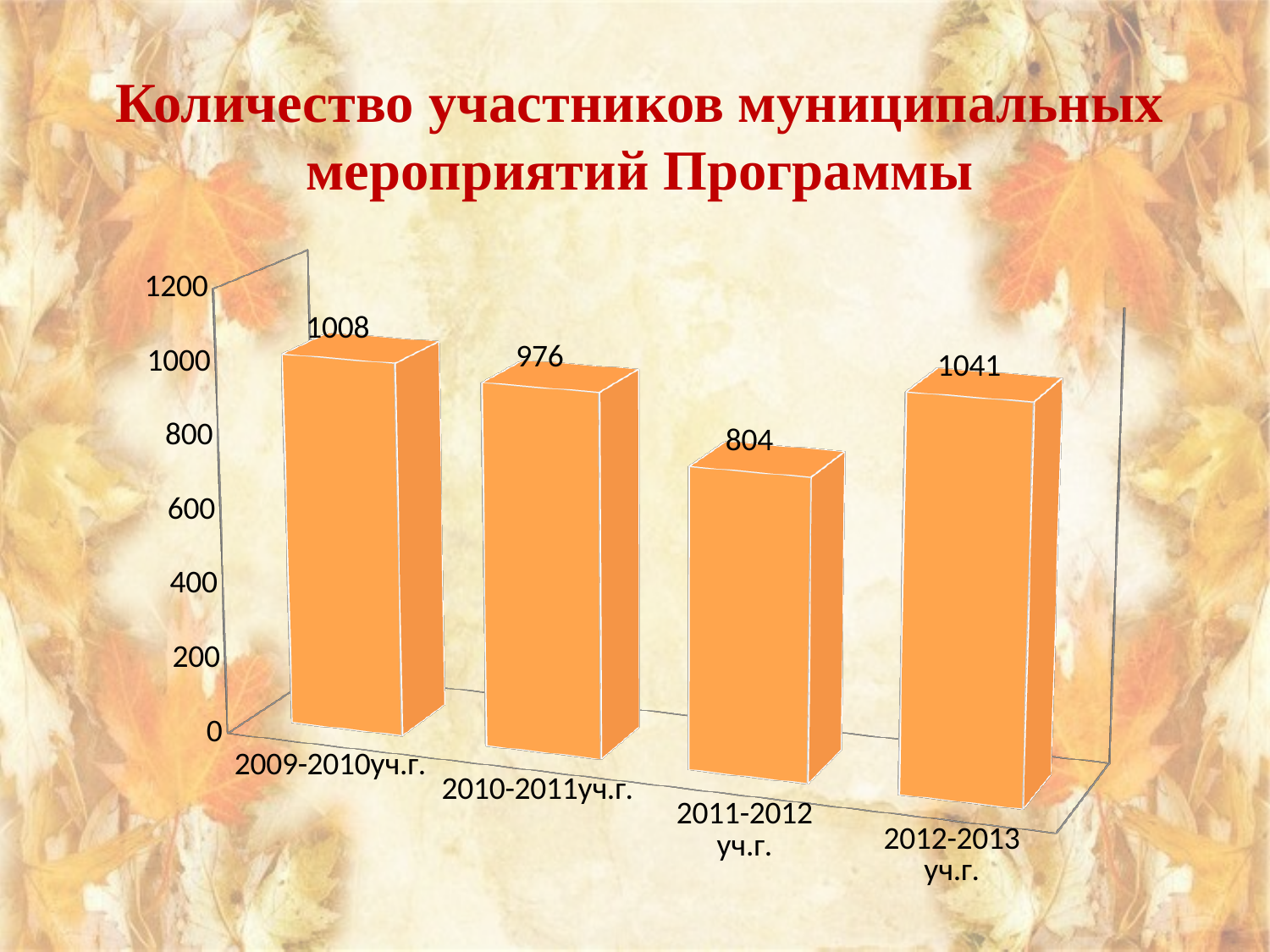
What is the difference between the values for 2009-2010 уч.г. and 2010-2011 уч.г.? 32 What is the value for 2011-2012 уч.г.? 804 What is the value for 2010-2011 уч.г.? 976 What is the difference between the values for 2012-2013 уч.г. and 2011-2012 уч.г.? 237 What is the value for 2009-2010 уч.г.? 1008 Is the value for 2011-2012 уч.г. greater or less than 1000? less How many academic years are shown on the chart? 4 Which is larger, the value for 2009-2010 уч.г. or 2010-2011 уч.г.? 2009-2010 уч.г. Which academic year has the lowest number of participants? 2011-2012 уч.г. What is the value for 2012-2013 уч.г.? 1041 Which academic year has the highest number of participants? 2012-2013 уч.г. What kind of chart is shown on the slide? bar chart